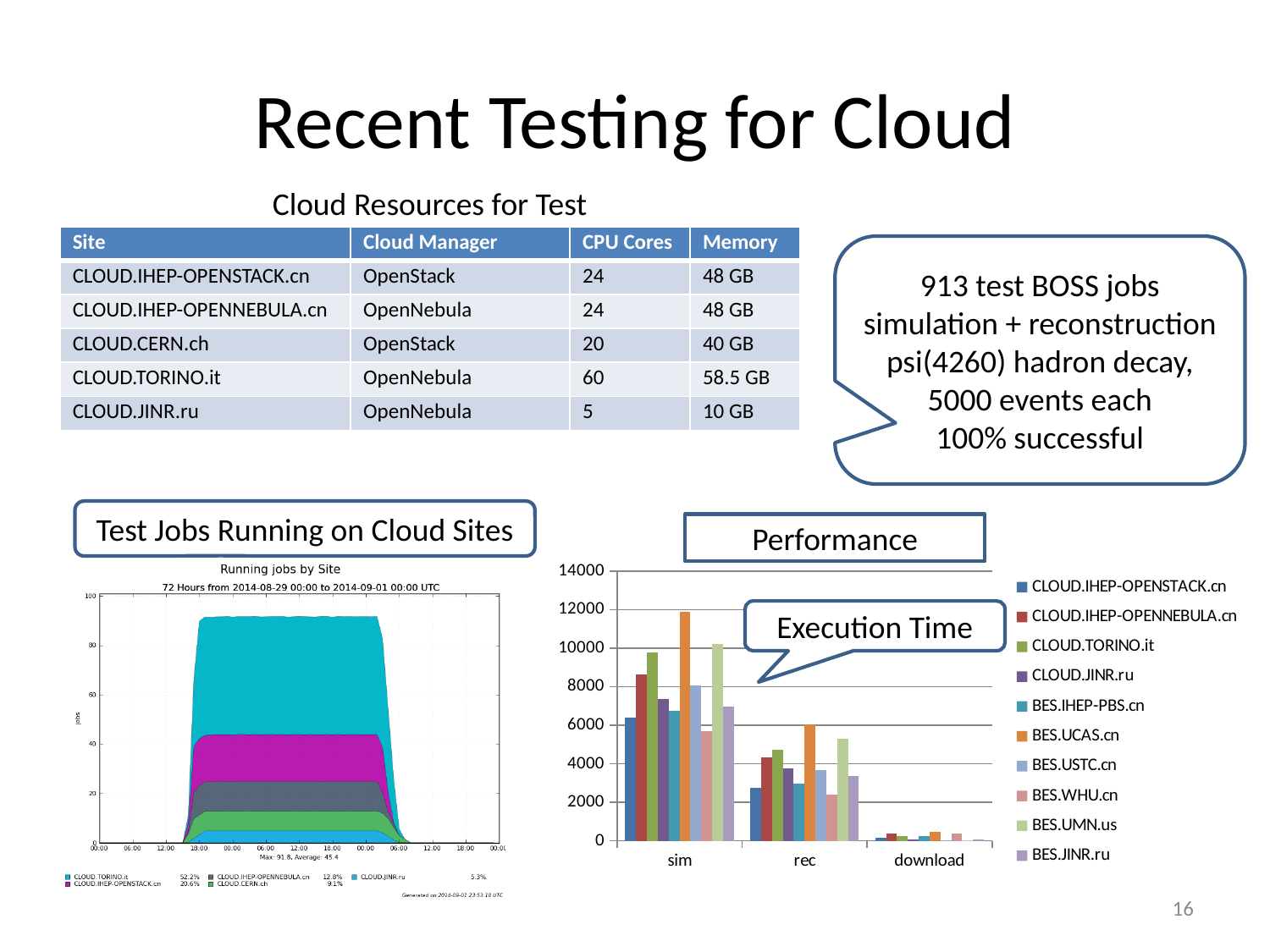
In the Performance chart, is the value for CLOUD.IHEP-OPENSTACK.cn in the sim category greater or less than 6000? greater In the Performance chart, which site has the highest value for rec? BES.UCAS.cn What kind of chart is the Performance chart on the right of the slide? bar chart In the Performance chart, how many series does the legend list? 10 In the Performance chart, which site has the highest value for sim? BES.UCAS.cn In the Running jobs by Site chart on the left, what percentage is shown in the legend for CLOUD.TORINO.it? 52.2% In the Performance chart, is the value for BES.UCAS.cn in the sim category greater or less than 10000? greater In the Performance chart, which is larger for the sim category: CLOUD.TORINO.it or CLOUD.IHEP-OPENSTACK.cn? CLOUD.TORINO.it In the Performance chart, is the value for BES.UCAS.cn in the rec category greater or less than 4000? greater In the Performance chart, how many categories are shown on the x axis? 3 In the Running jobs by Site chart on the left, what maximum value is printed below the plot? 91.8 In the Performance chart, do the values for BES.UCAS.cn rise or fall from sim to rec to download? fall